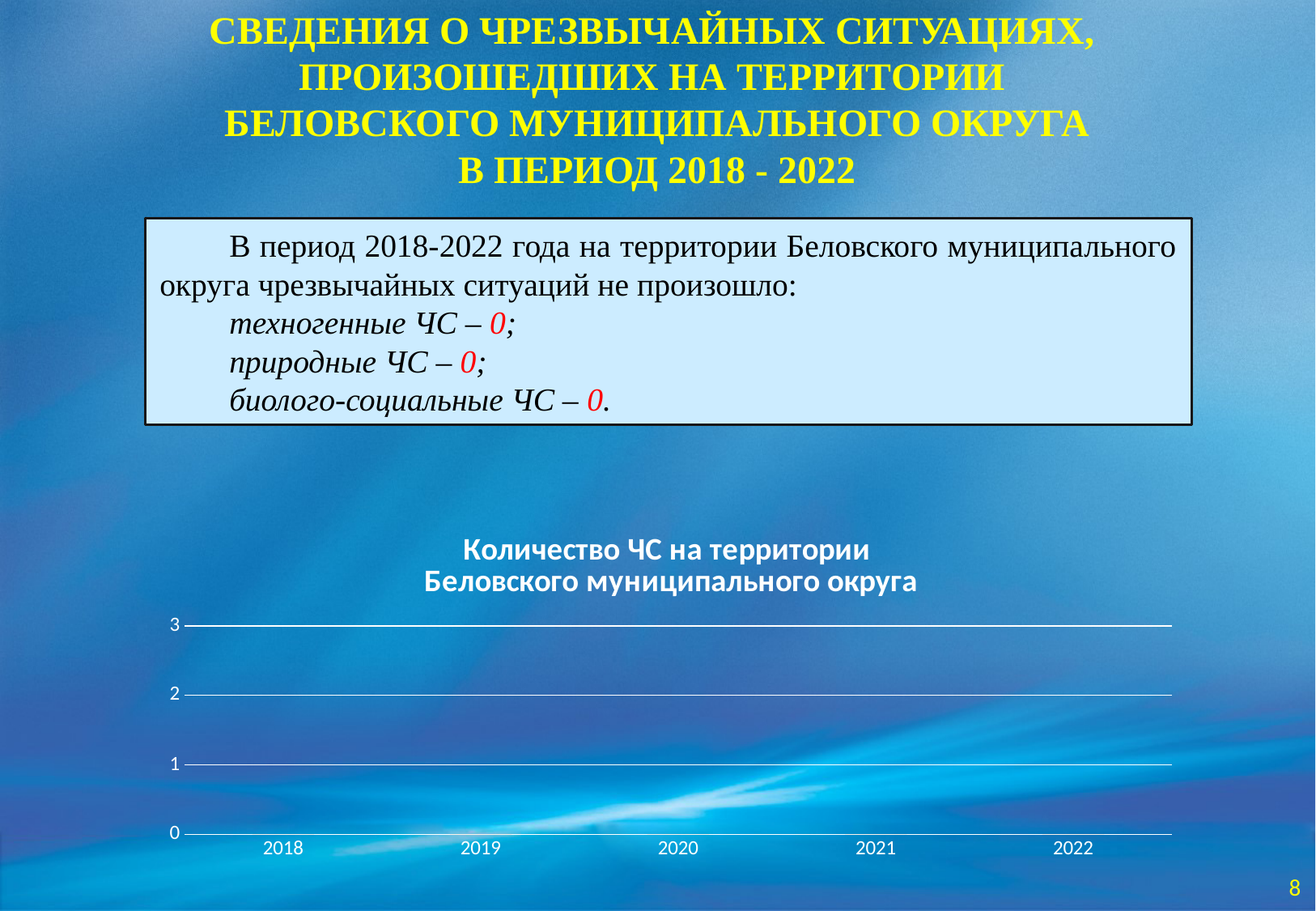
How many years are shown on the x axis of the chart? 5 Is the value for 2020 greater or less than 1? less What is the number of emergencies (ЧС) shown for 2019? 0 What is the title of the chart at the bottom of the slide? Количество ЧС на территории Беловского муниципального округа Is the value for 2022 greater or less than 2? less Do the values rise, fall, or stay the same from 2018 to 2022? stay the same Is the value for 2018 greater or less than 1? less What is the total number of emergencies across all five years shown in the chart? 0 What is the highest value marked on the y axis of the chart? 3 What is the number of emergencies (ЧС) shown for 2021? 0